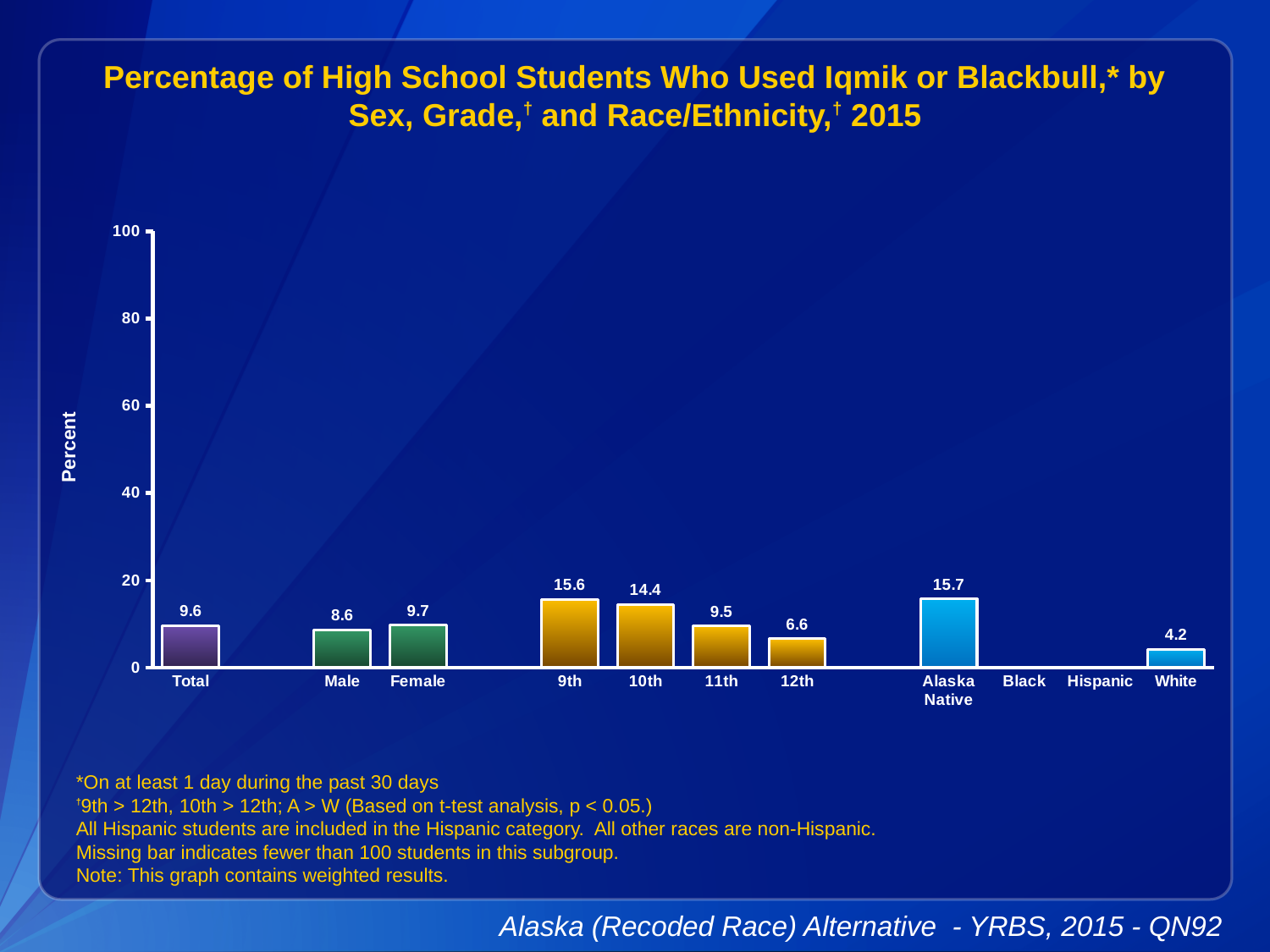
What is the percentage for 9th grade students? 15.6 What is the percentage for Alaska Native students? 15.7 How many categories have no bar plotted? 2 What is the percentage for Total? 9.6 Which is larger, the value for 10th grade or the value for 11th grade? 10th What is the percentage for White students? 4.2 How many categories are labeled on the x axis? 11 Is the value for 9th grade greater or less than 20? less What is the difference between the 9th grade and 12th grade values? 9.0 Which category has the lowest plotted value? White What is the difference between the Female and Male values? 1.1 What kind of chart is shown on the slide? bar chart